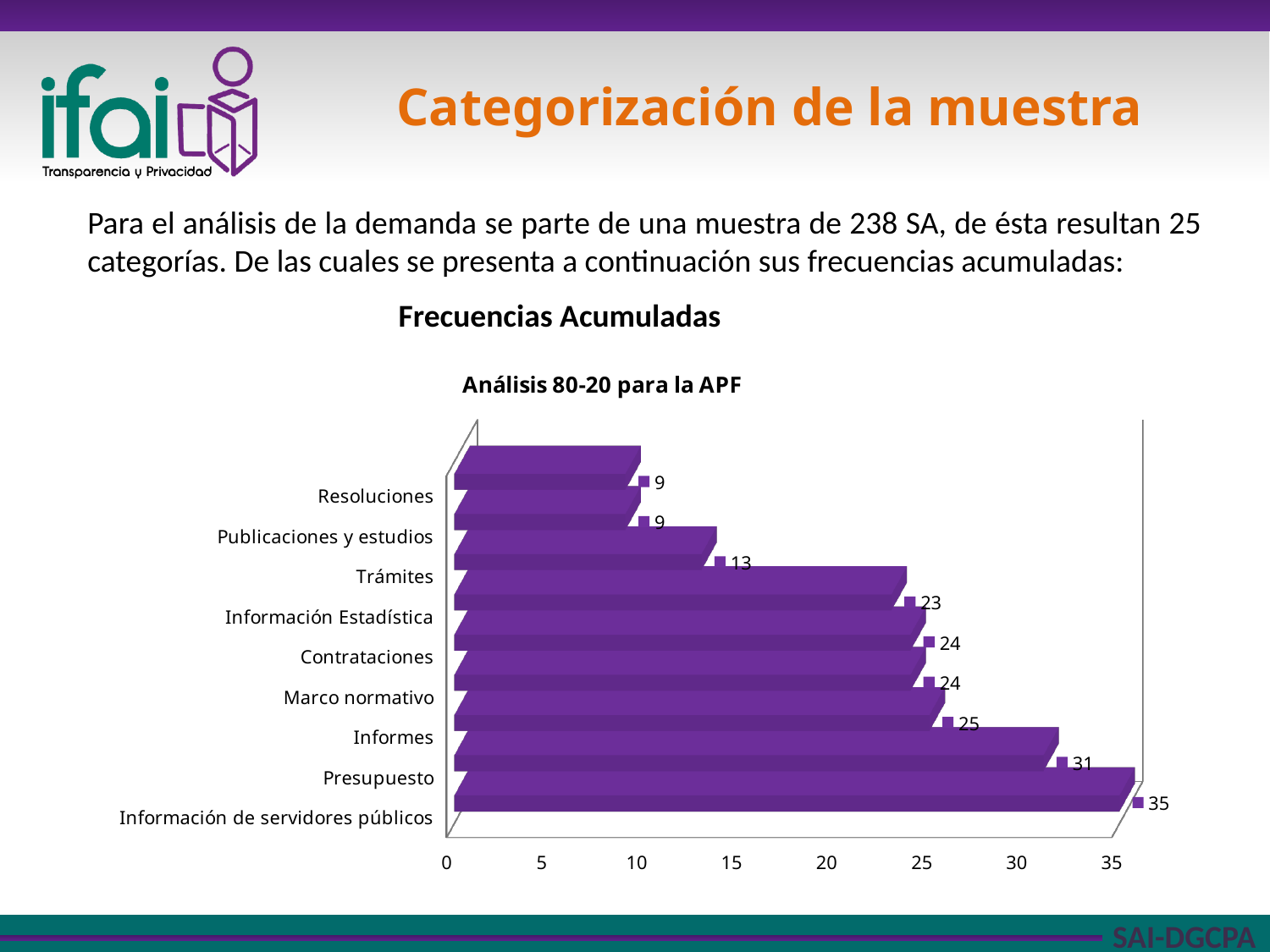
What is the value for Información de servidores públicos? 35 How many categories are shown in the chart? 9 What is the difference between the values for Información de servidores públicos and Presupuesto? 4 What is the value for Trámites? 13 What kind of chart is shown on the slide? Bar chart Is the value for Información Estadística greater or less than 20? greater What is the difference between the values for Información Estadística and Trámites? 10 What is the value for Informes? 25 Which category has the highest value? Información de servidores públicos What is the value for Presupuesto? 31 What is the title of the chart? Análisis 80-20 para la APF Which is larger, the value for Presupuesto or the value for Informes? Presupuesto